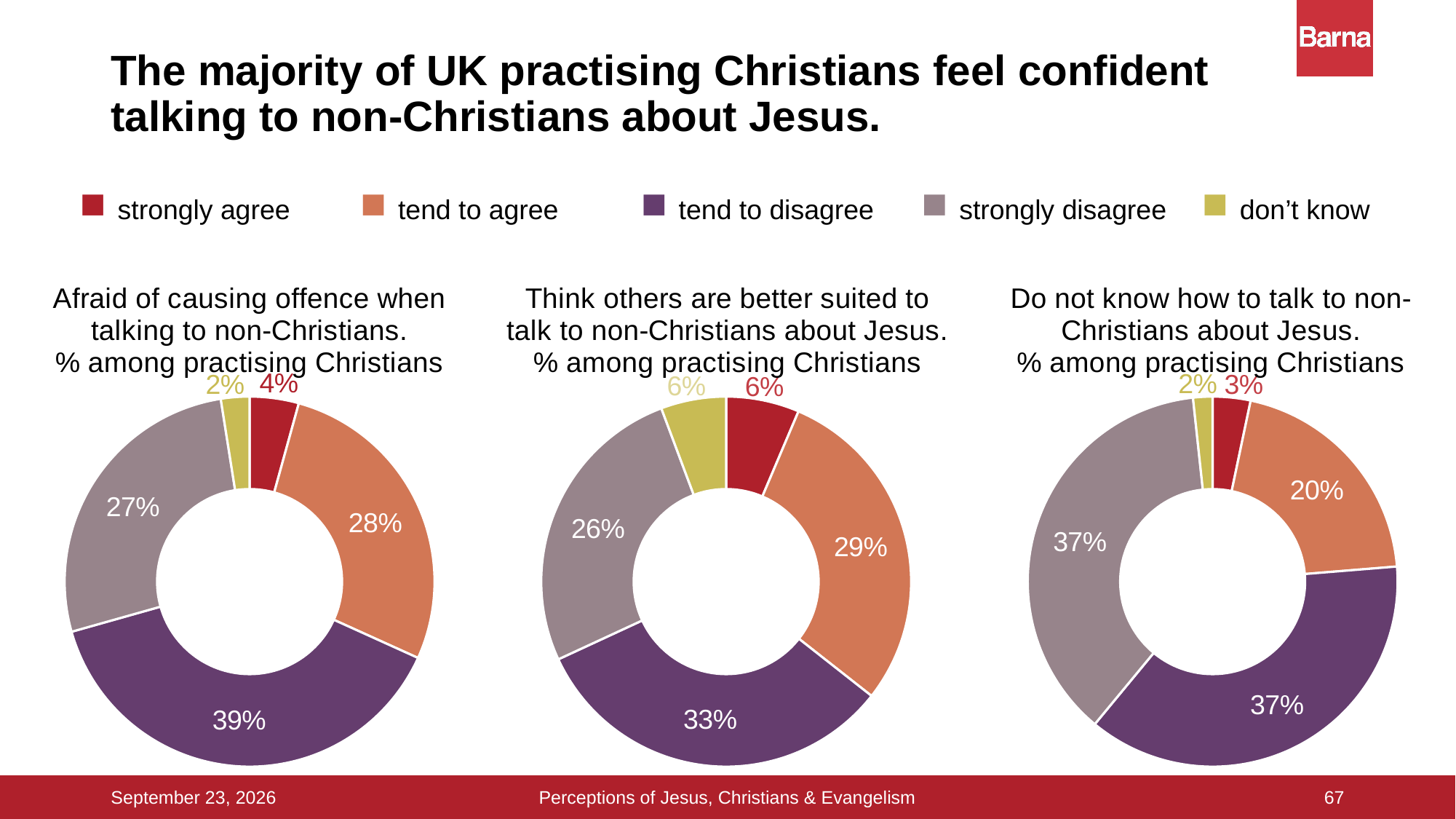
In the 'Think others are better suited to talk to non-Christians about Jesus' chart, what is the difference between the tend to disagree and strongly disagree shares? 7% In the 'Do not know how to talk to non-Christians about Jesus' chart, which response has the smallest share? don't know In the 'Think others are better suited to talk to non-Christians about Jesus' chart, which response has the largest share? tend to disagree In the 'Afraid of causing offence when talking to non-Christians' chart, which response has the largest share? tend to disagree In the 'Do not know how to talk to non-Christians about Jesus' chart, what percentage tend to agree? 20% In the 'Afraid of causing offence when talking to non-Christians' chart, what percentage strongly agree? 4% What type of chart is used on this slide? Donut (pie) chart In the 'Do not know how to talk to non-Christians about Jesus' chart, which is larger: tend to agree or strongly disagree? strongly disagree In the 'Afraid of causing offence when talking to non-Christians' chart, what percentage tend to disagree? 39% In the 'Afraid of causing offence when talking to non-Christians' chart, which response has the smallest share? don't know How many response categories does the legend list? 5 In the 'Think others are better suited to talk to non-Christians about Jesus' chart, what percentage tend to agree? 29%